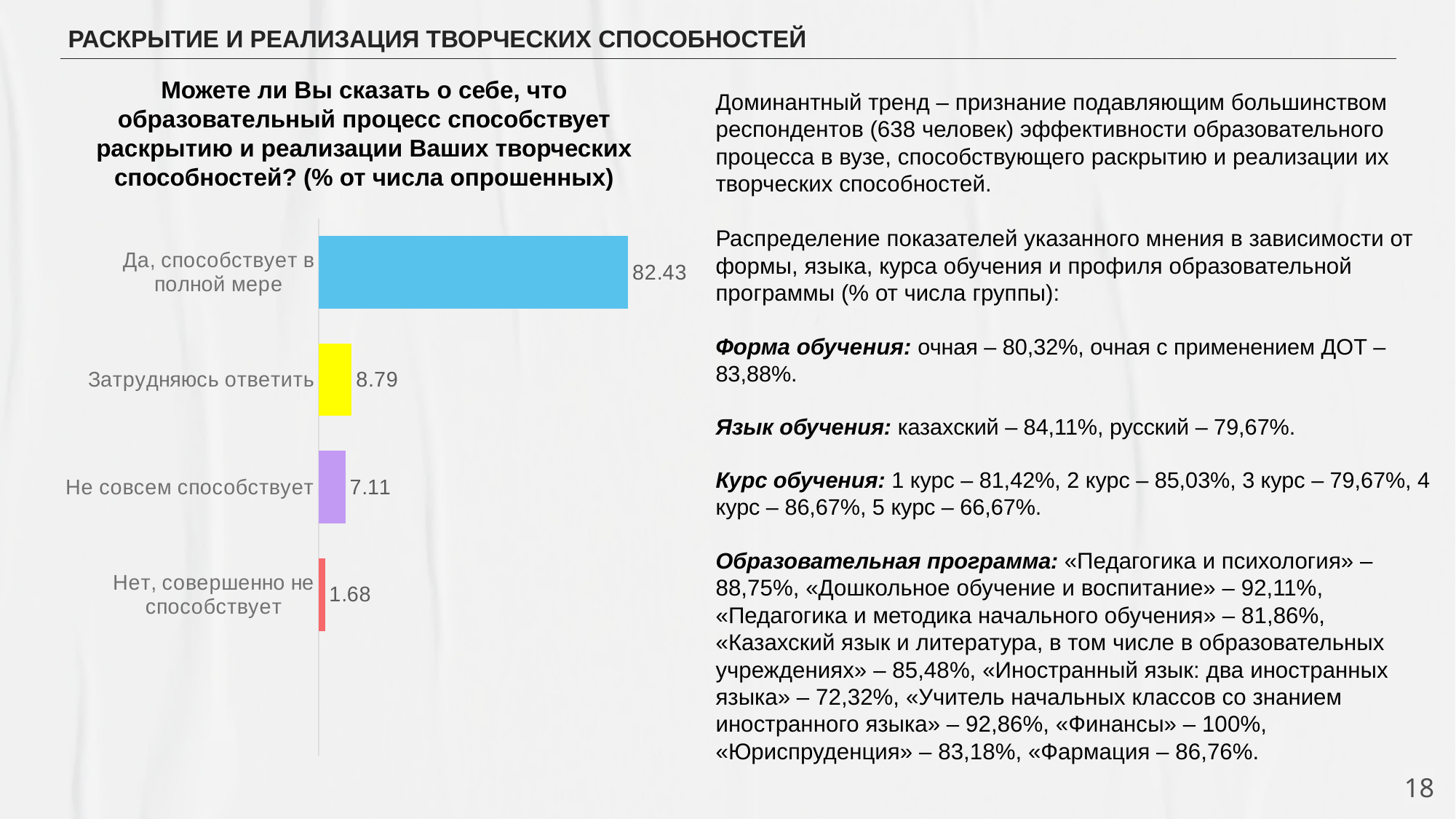
What colour is the bar for "Затрудняюсь ответить"? Yellow What is the value for "Да, способствует в полной мере"? 82.43 Which category has the highest value? Да, способствует в полной мере What is the difference between the values for "Да, способствует в полной мере" and "Затрудняюсь ответить"? 73.64 What kind of chart is shown on the slide? Bar chart Which category has the lowest value? Нет, совершенно не способствует What is the value for "Затрудняюсь ответить"? 8.79 How many categories are shown in the chart? 4 What is the difference between the values for "Затрудняюсь ответить" and "Не совсем способствует"? 1.68 What is the value for "Нет, совершенно не способствует"? 1.68 What is the value for "Не совсем способствует"? 7.11 Which is larger, the value for "Не совсем способствует" or the value for "Нет, совершенно не способствует"? Не совсем способствует